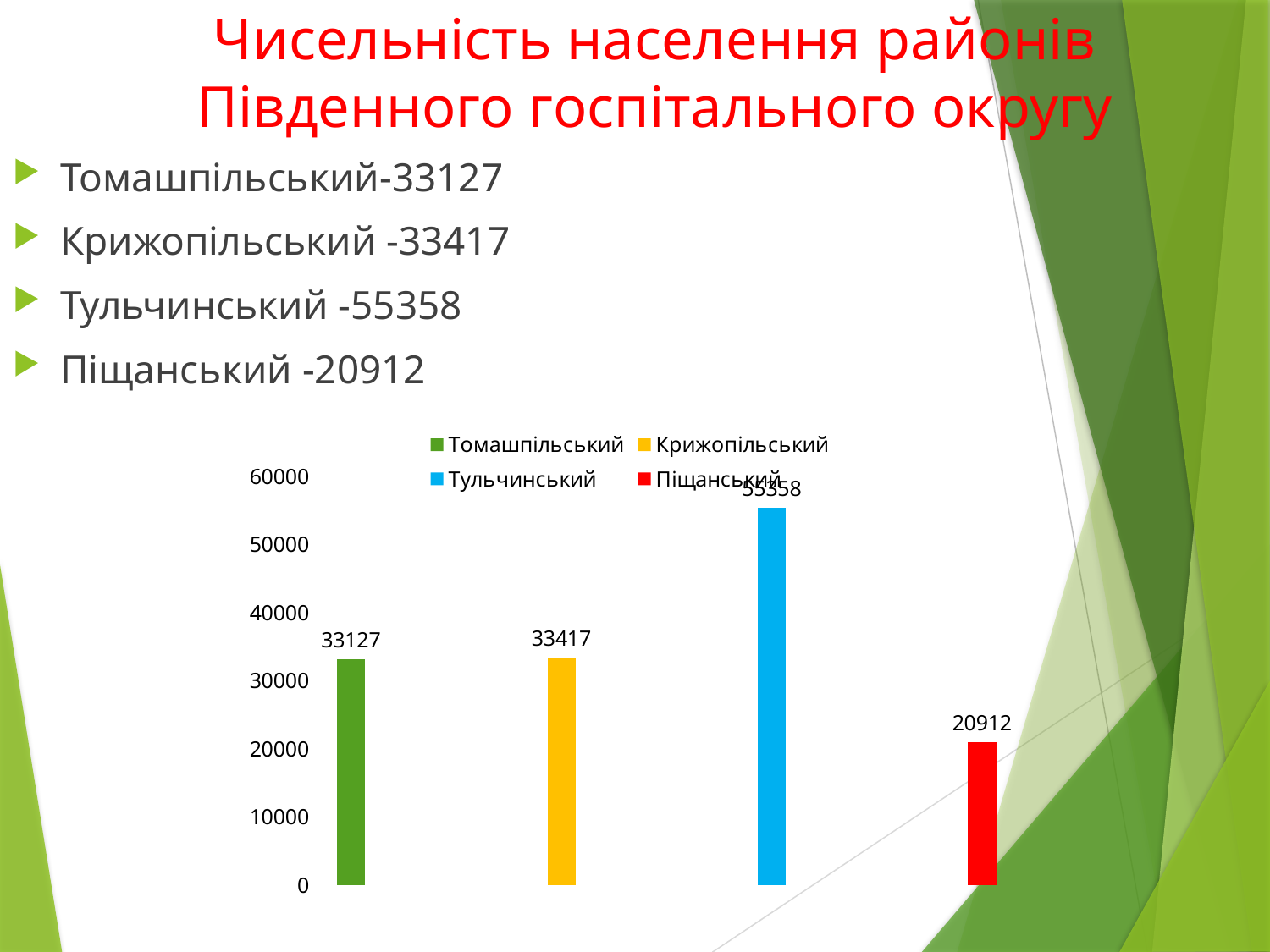
Is the value for Піщанський greater or less than 30000? less Which district has the highest value in the chart? Тульчинський What is the value shown for Тульчинський in the chart? 55358 What is the difference between the values for Крижопільський and Томашпільський? 290 What is the difference between the values for Тульчинський and Піщанський? 34446 What is the value shown for Крижопільський in the chart? 33417 What is the value shown for Піщанський in the chart? 20912 How many series does the chart legend list? 4 Which district has the lowest value in the chart? Піщанський What is the value shown for Томашпільський in the chart? 33127 Which is larger, the value for Тульчинський or the value for Крижопільський? Тульчинський What kind of chart is shown on the slide? bar chart